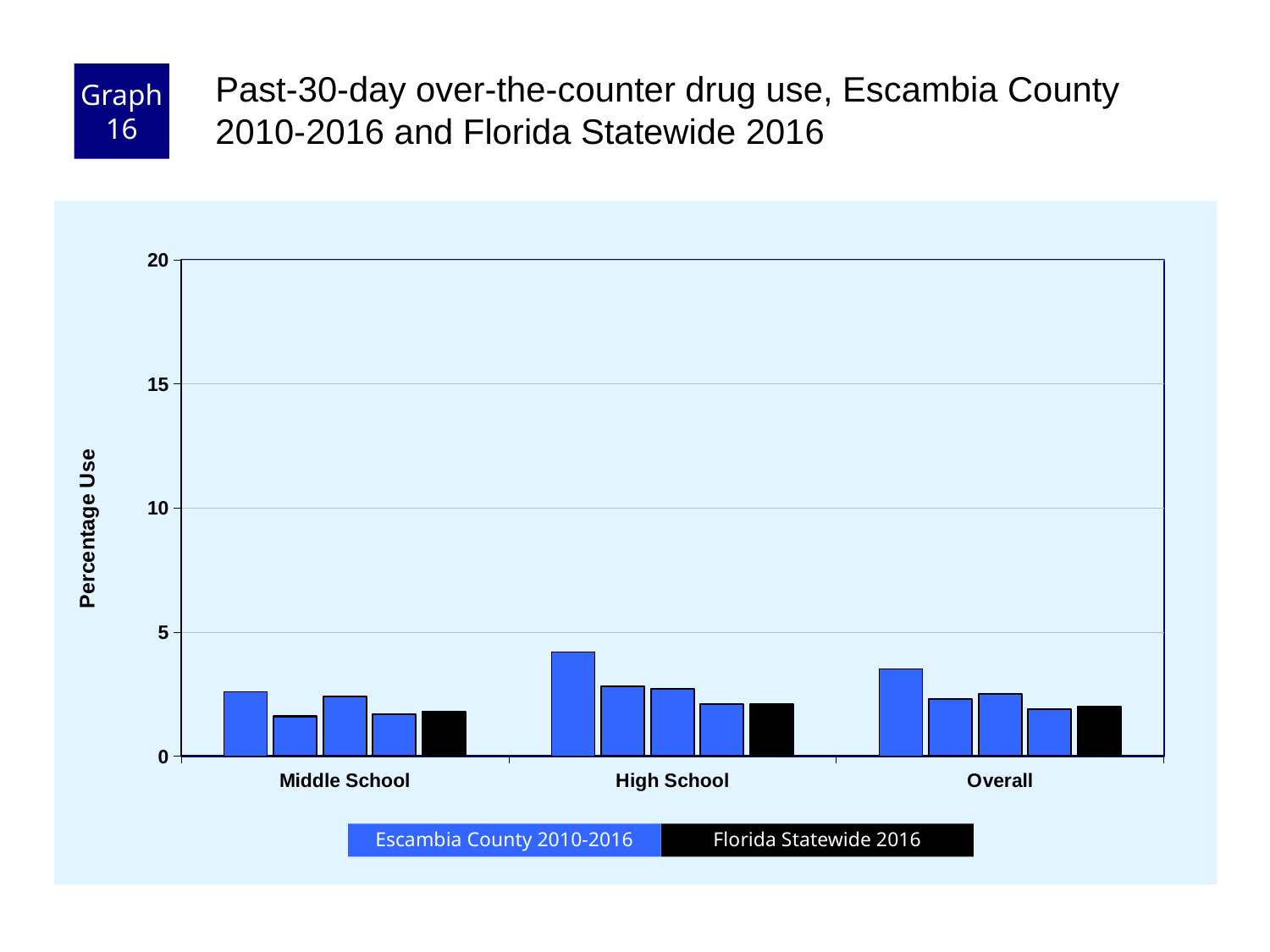
Is the value for Florida Statewide 2016 in the Overall category greater or less than 10? less How many series does the legend list? 2 How many categories are shown on the x axis? 3 What is the label of the y axis? Percentage Use Which category has the lowest Florida Statewide 2016 bar? Middle School Which category contains the tallest bar on the chart? High School What colour represents Florida Statewide 2016 in the legend? black Is the tallest Escambia County bar in the High School category greater or less than 5? less Is the value for Florida Statewide 2016 in the High School category greater or less than 5? less What kind of chart is shown on the slide? bar chart Is the Florida Statewide 2016 bar larger for Middle School or for High School? High School Is the tallest Escambia County bar larger in the Middle School category or in the High School category? High School